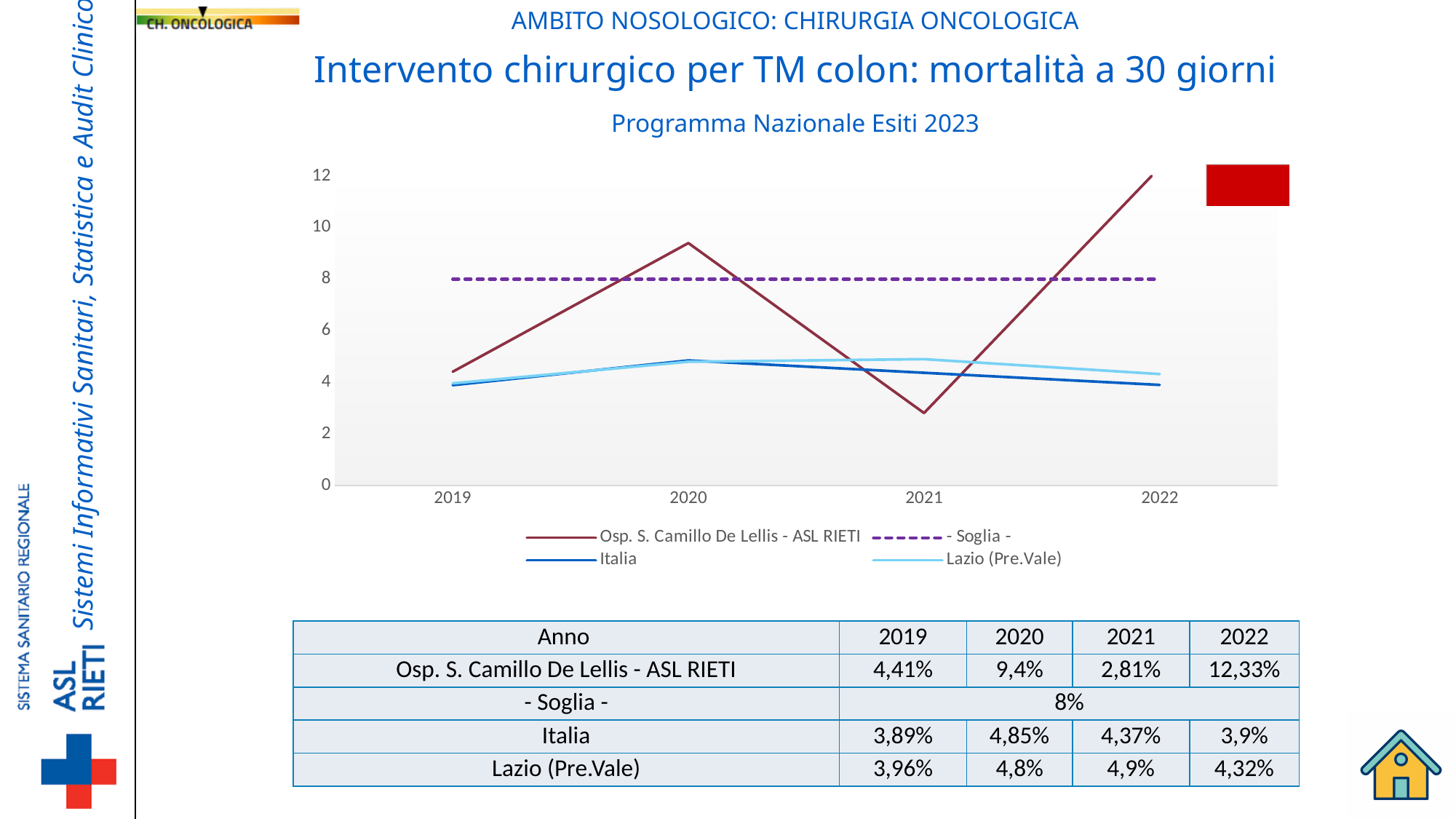
Is the value for Osp. S. Camillo De Lellis - ASL RIETI in 2020 greater or less than 8? greater What is the value for Osp. S. Camillo De Lellis - ASL RIETI in 2022? 12,33% In which year is the value for Osp. S. Camillo De Lellis - ASL RIETI highest? 2022 What kind of chart is shown on the slide? line chart How many years are plotted along the x axis of the chart? 4 What is the value of the Soglia line? 8% In which year is the value for Osp. S. Camillo De Lellis - ASL RIETI lowest? 2021 In 2021, which is larger: the value for Italia or the value for Lazio (Pre.Vale)? Lazio (Pre.Vale) Does the Italia line rise or fall from 2020 to 2022? fall What is the difference between the 2022 values for Osp. S. Camillo De Lellis - ASL RIETI and Italia? 8,43% What is the value for Italia in 2020? 4,85% How many series does the chart legend list? 4